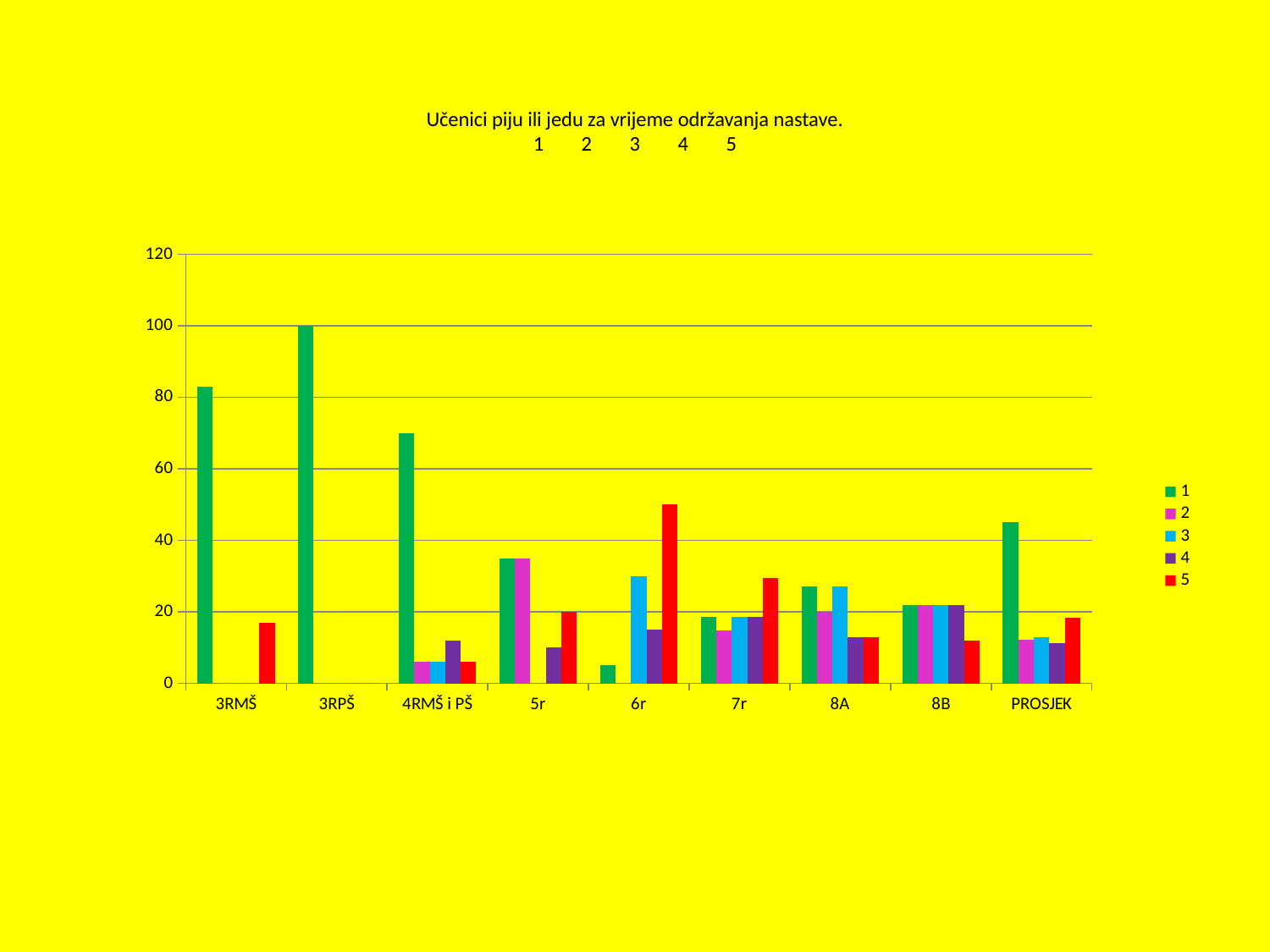
How many categories are shown on the x axis of the chart? 9 Which category has the highest value for series 1? 3RPŠ Which is larger: the value of series 1 for 3RMŠ or the value of series 1 for 4RMŠ i PŠ? 3RMŠ Is the value of series 5 for 6r greater or less than 40? greater How many series does the legend list? 5 What kind of chart is shown on the slide? bar chart Which category has the lowest value for series 1? 6r Is the value of series 1 for 6r greater or less than 20? less Which is larger: the value of series 5 for 6r or the value of series 5 for 7r? 6r What colour represents series 5 in the chart? red What is the value of series 1 for 3RPŠ? 100 Is the value of series 1 for 4RMŠ i PŠ greater or less than 60? greater